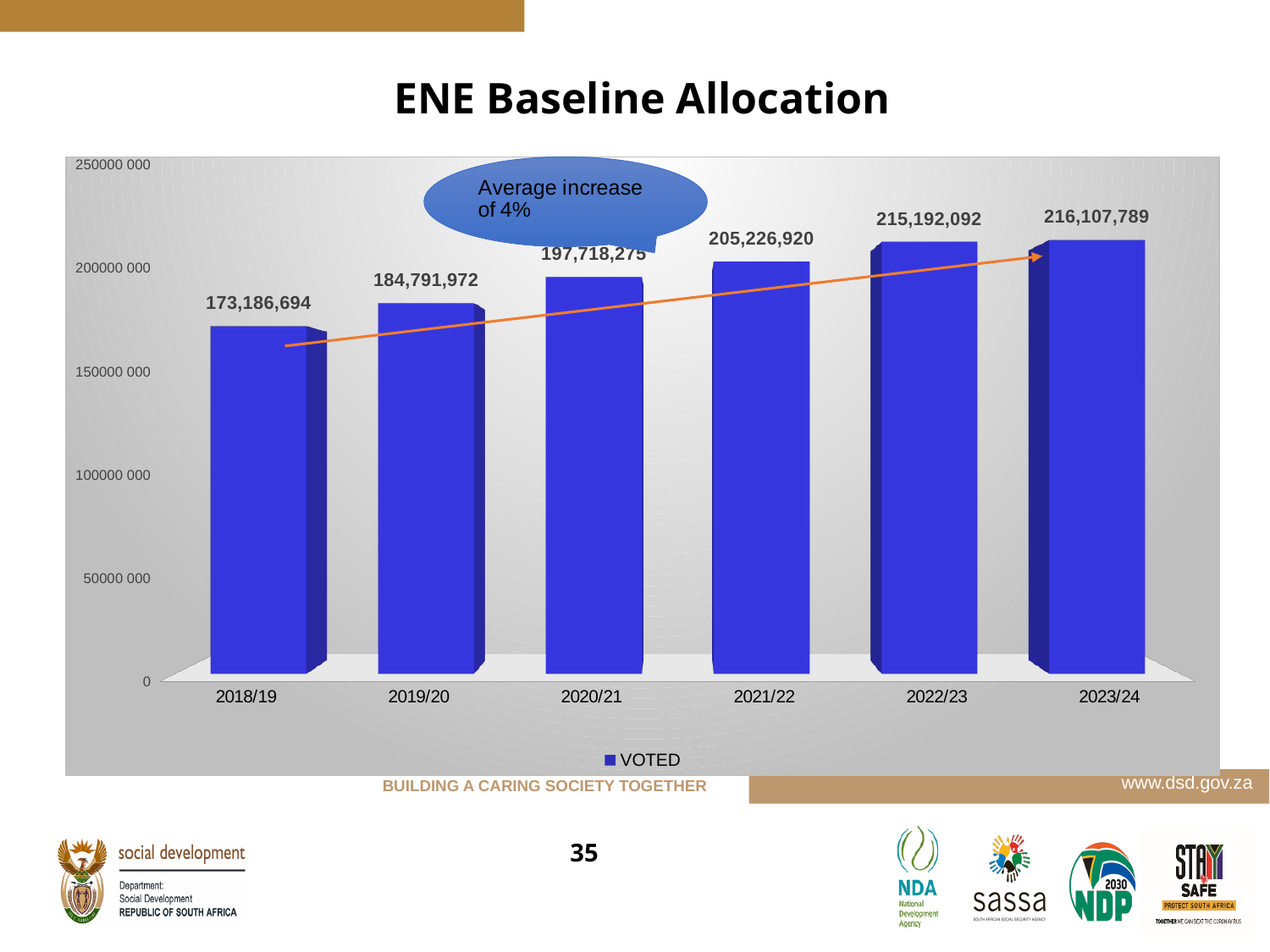
Do the allocations rise or fall from 2018/19 to 2023/24? Rise What is the VOTED allocation for 2021/22? 205,226,920 How many years are shown on the x axis? 6 Which year has the highest VOTED allocation? 2023/24 What is the VOTED allocation for 2023/24? 216,107,789 Which is larger, the allocation for 2019/20 or for 2021/22? 2021/22 What is the difference between the 2023/24 and 2018/19 allocations? 42,921,095 Is the allocation for 2020/21 greater or less than 200000 000? less What kind of chart is shown on the slide? Bar chart What is the difference between the 2019/20 and 2018/19 allocations? 11,605,278 What is the VOTED allocation for 2018/19? 173,186,694 Which year has the lowest VOTED allocation? 2018/19